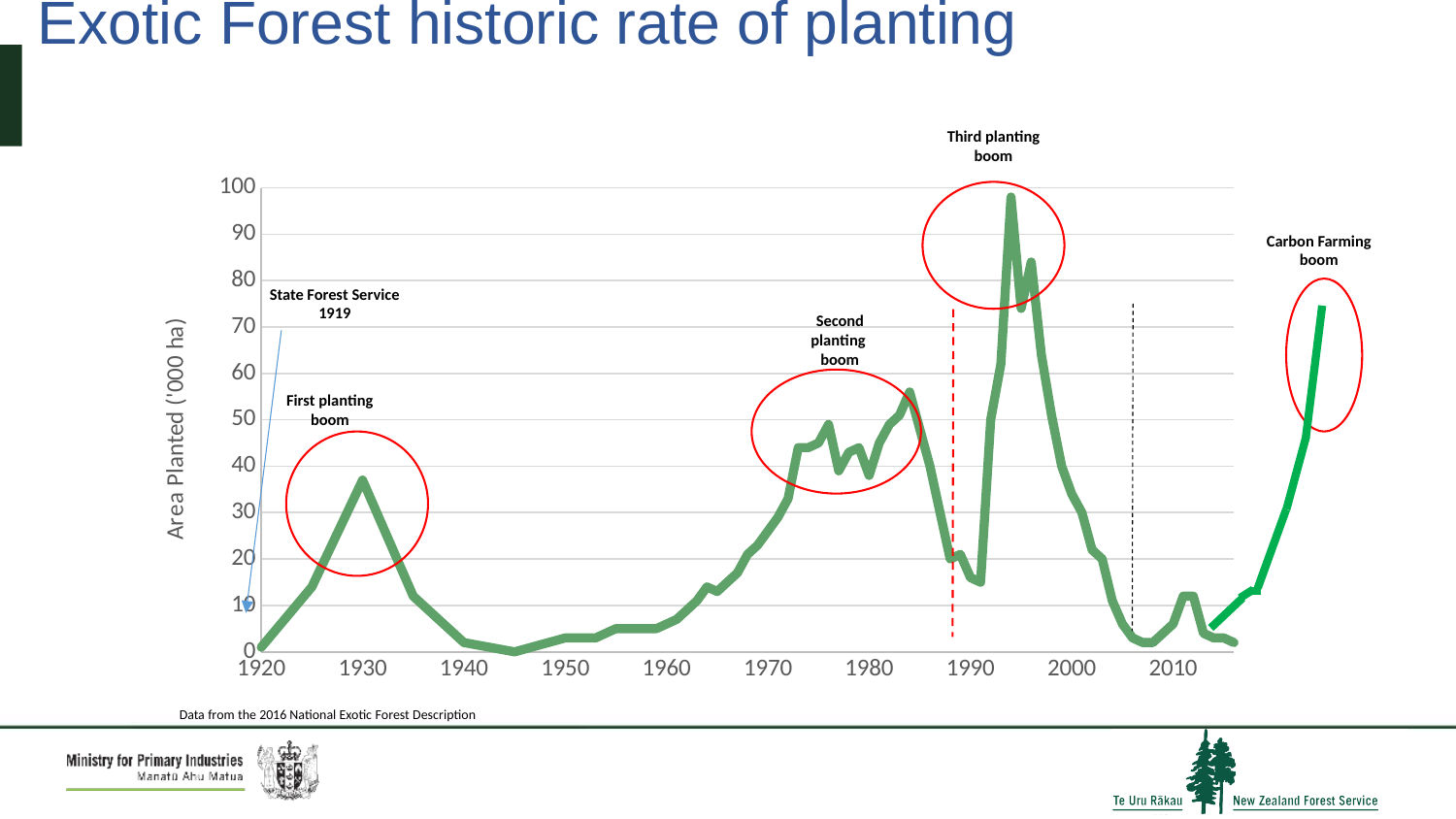
What kind of chart is shown on the slide? line chart Which of the annotated planting booms reaches the highest area planted? Third planting boom Does the area planted rise or fall between 1930 and 1940? fall Does the area planted rise or fall between 1960 and 1970? rise What is the label on the vertical axis of the chart? Area Planted ('000 ha) Which has the higher peak, the first planting boom or the second planting boom? Second planting boom Which has the higher peak, the second planting boom or the third planting boom? Third planting boom Is the peak value of the first planting boom (around 1930) greater or less than 50? less Is the peak value of the third planting boom (around 1994) greater or less than 90? greater Is the final value of the Carbon Farming boom line greater or less than 60? greater What is the title of the chart on the slide? Exotic Forest historic rate of planting